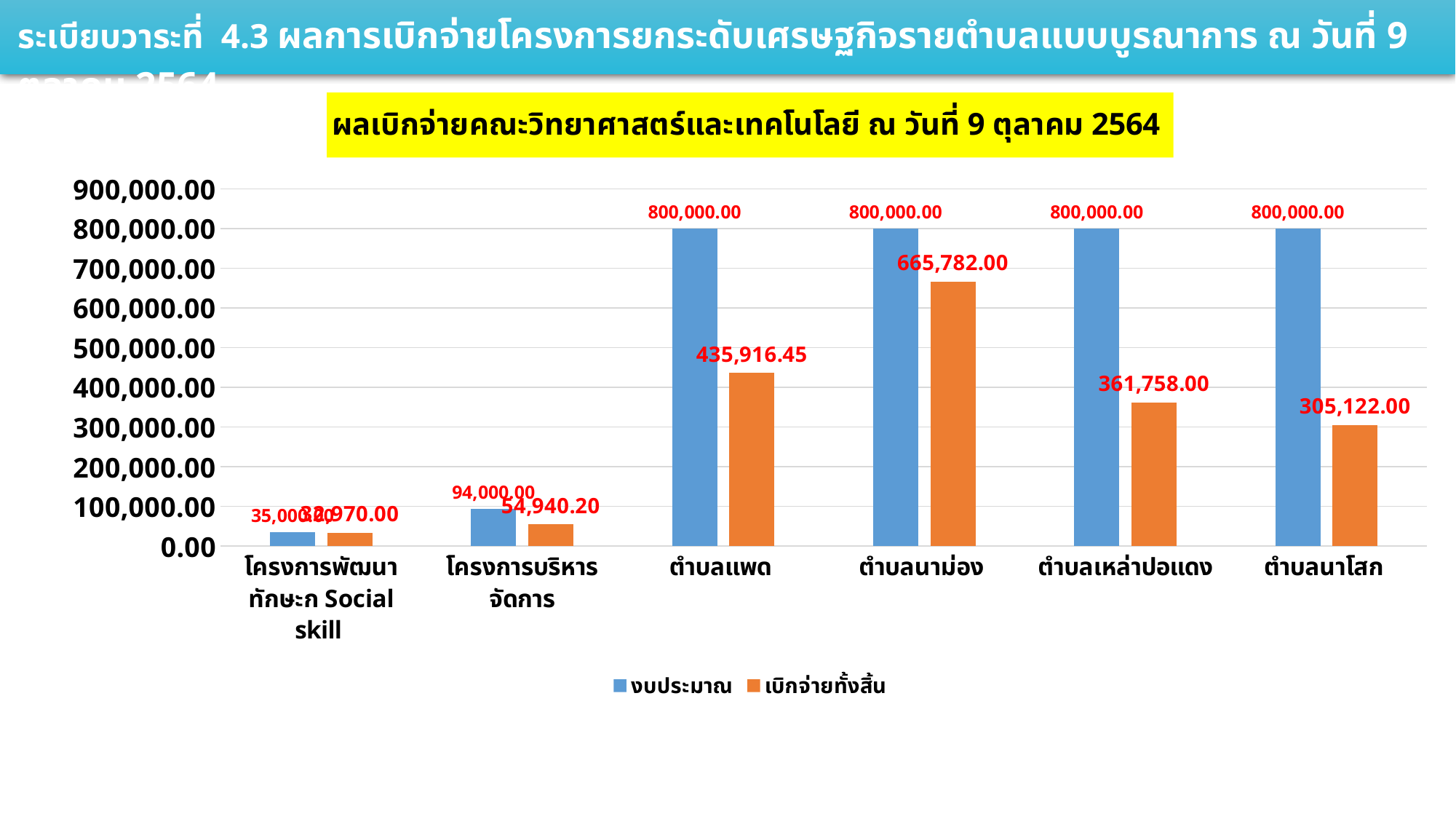
What is the งบประมาณ value for โครงการบริหารจัดการ? 94,000.00 What is the เบิกจ่ายทั้งสิ้น value for ตำบลแพด? 435,916.45 What type of chart is shown on the slide? bar chart What is the เบิกจ่ายทั้งสิ้น value for ตำบลนาม่อง? 665,782.00 Is the เบิกจ่ายทั้งสิ้น value for ตำบลแพด greater or less than 400,000.00? greater Which is larger, the เบิกจ่ายทั้งสิ้น value for ตำบลเหล่าปอแดง or for ตำบลนาโสก? ตำบลเหล่าปอแดง What is the difference between งบประมาณ and เบิกจ่ายทั้งสิ้น for ตำบลเหล่าปอแดง? 438,242.00 How many categories are shown on the x axis? 6 Which colour represents the งบประมาณ series? blue Which category has the highest เบิกจ่ายทั้งสิ้น value? ตำบลนาม่อง How many series does the legend list? 2 What is the เบิกจ่ายทั้งสิ้น value for ตำบลนาโสก? 305,122.00